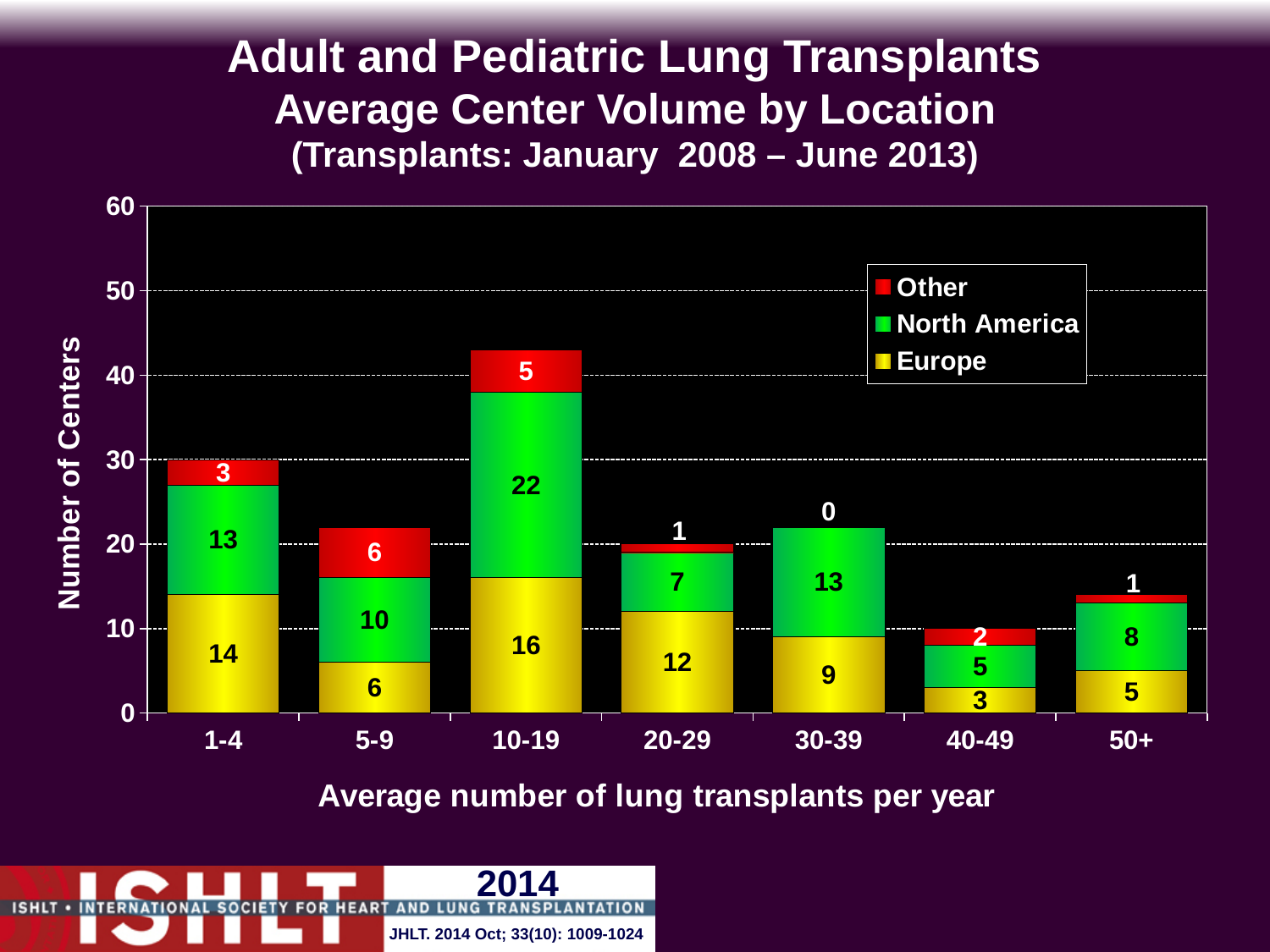
What is the difference between the North America value for 10-19 and the North America value for 20-29? 15 Which category has the lowest Europe value? 40-49 What is the label of the y axis? Number of Centers What is the Other value for the 5-9 category? 6 How many categories are shown on the x axis? 7 How many series does the legend list? 3 Which category has the highest North America value? 10-19 What is the Europe value for the 10-19 category? 16 What is the total number of centers for the 1-4 category? 30 What is the North America value for the 30-39 category? 13 Which is larger, the Europe value for 20-29 or the Europe value for 30-39? Europe value for 20-29 What type of chart is shown on the slide? Stacked bar chart